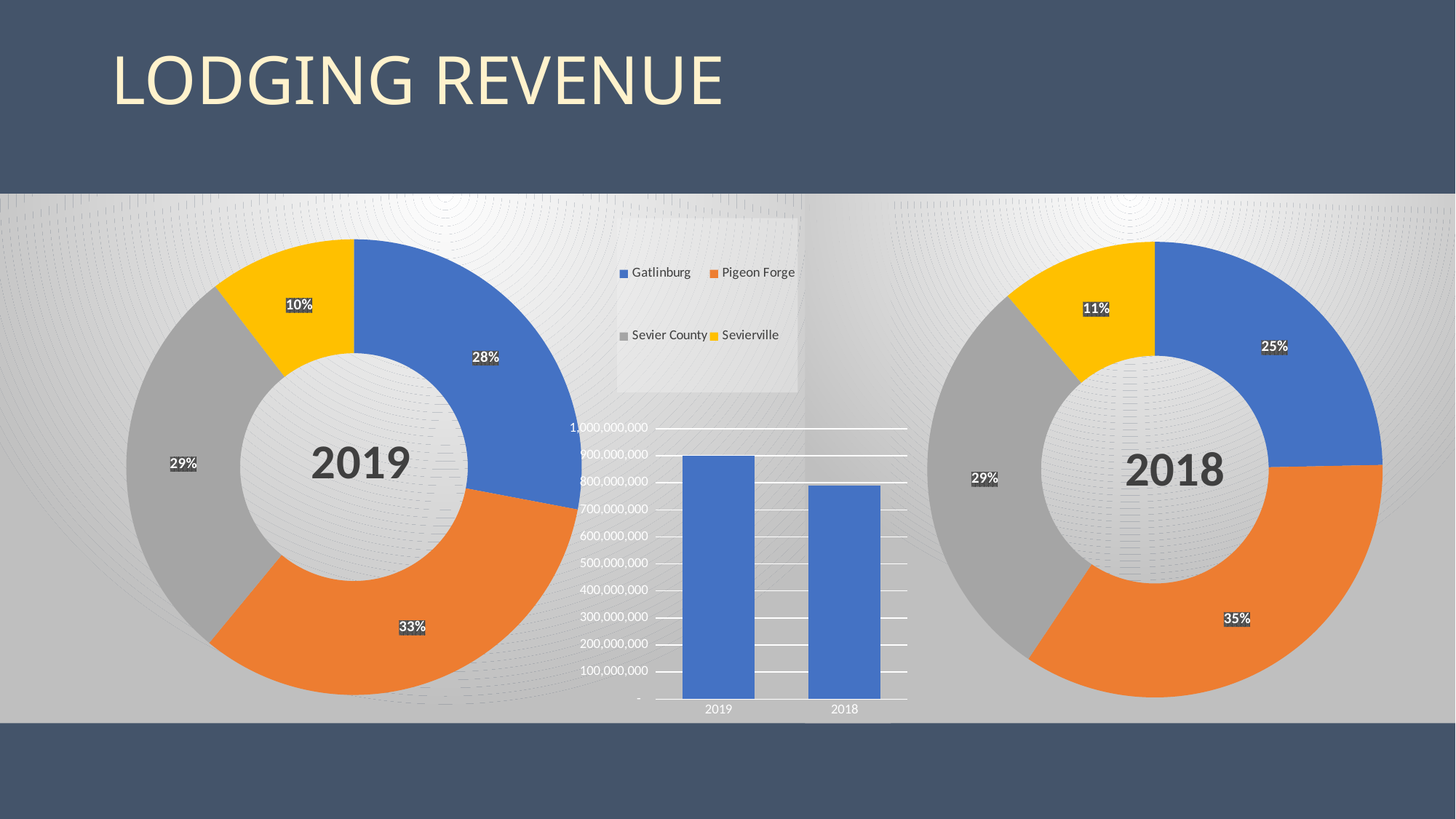
What kind of chart is shown in the middle of the slide? Bar chart In the 2018 doughnut chart, what is the difference between the Pigeon Forge share and the Sevierville share? 24% How many entries does the legend list for the doughnut charts? 4 In the 2018 doughnut chart, which category has the largest share? Pigeon Forge In the 2019 doughnut chart, which is larger: the Gatlinburg share or the Sevier County share? Sevier County In the 2018 doughnut chart, what share does Gatlinburg have? 25% In the middle bar chart, is the value for 2019 greater or less than 800,000,000? greater In the 2019 doughnut chart, which category has the smallest share? Sevierville In the 2019 doughnut chart, what share does Pigeon Forge have? 33% In the middle bar chart, which year has the higher bar? 2019 In the 2019 doughnut chart, what share does Sevierville have? 10%